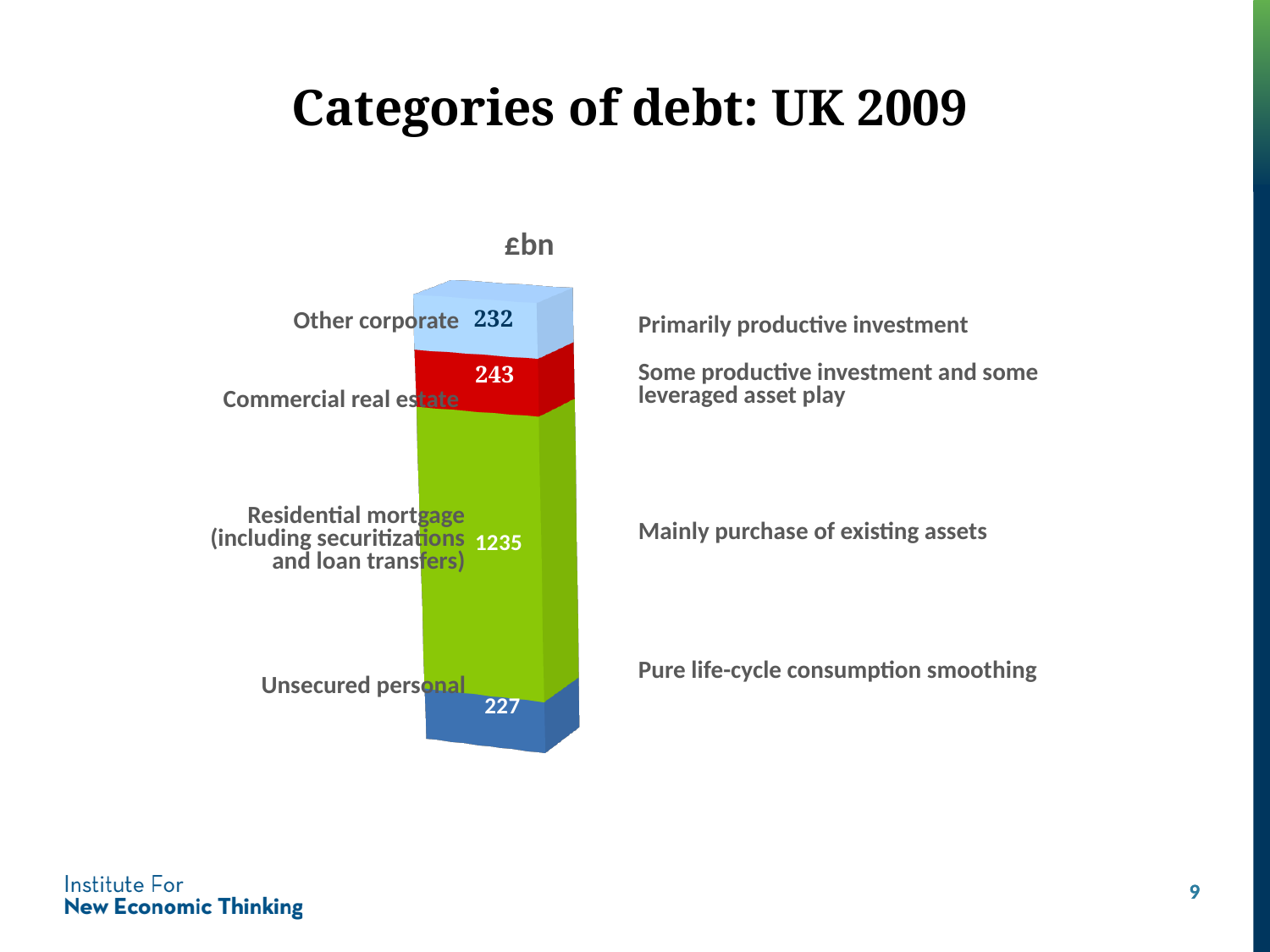
What is the value for Commercial real estate? 243 What is the total of all segments in the stacked bar? 1937 What unit is shown above the chart? £bn What is the difference between the Commercial real estate value and the Other corporate value? 11 What is the value for Residential mortgage (including securitizations and loan transfers) in the stacked bar? 1235 How many debt categories are stacked in the bar? 4 Which is larger, Other corporate or Unsecured personal? Other corporate What is the difference between the Residential mortgage value and the Commercial real estate value? 992 Which category of debt has the largest value? Residential mortgage (including securitizations and loan transfers) What is the value for Unsecured personal? 227 What is the value for Other corporate? 232 Which category of debt has the smallest value? Unsecured personal